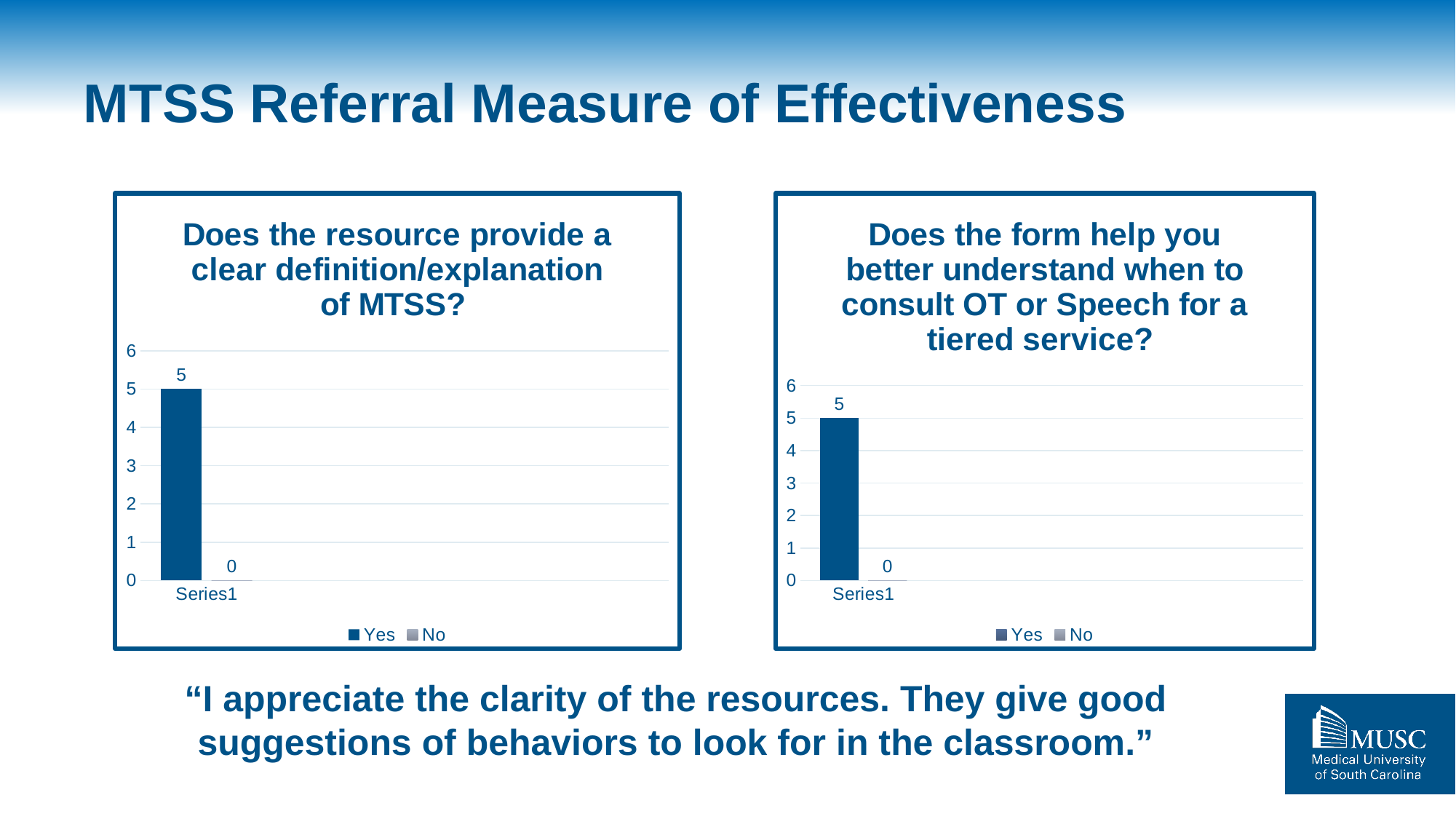
In the right chart, which series has the lowest value? No In the right chart, what is the difference between the Yes and No values? 5 In the right chart, what is the value for Yes? 5 What kind of chart is the right chart? Bar chart In the left chart, what is the value for Yes? 5 In the right chart, what is the value for No? 0 In the left chart, which series has the higher value, Yes or No? Yes What is the highest value shown on the y axis of the right chart? 6 In the left chart, what is the difference between the Yes and No values? 5 In the left chart, what is the value for No? 0 What is the title of the left chart? Does the resource provide a clear definition/explanation of MTSS? How many series does the legend of the left chart list? 2